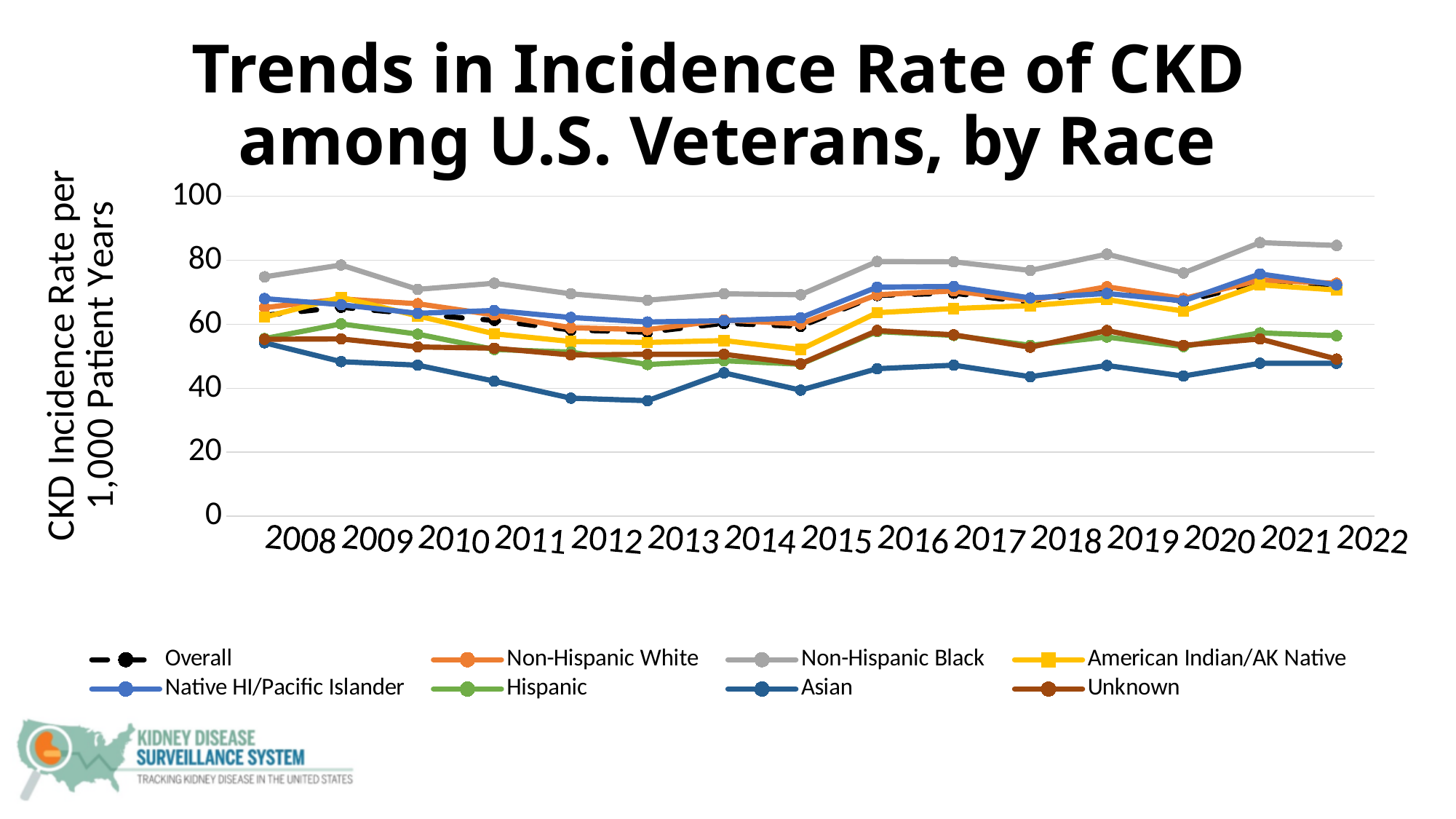
Is the value for Hispanic in 2008 greater or less than 60? less Does the Asian series rise or fall from 2008 to 2012? fall Is the value for Non-Hispanic Black in 2021 greater or less than 80? greater What is the title of the chart? Trends in Incidence Rate of CKD among U.S. Veterans, by Race Which race group has the lowest CKD incidence rate in 2012? Asian How many years are plotted along the x axis? 15 Which race group has the highest CKD incidence rate in 2022? Non-Hispanic Black In 2015, which is larger: the value for Non-Hispanic Black or the value for Asian? Non-Hispanic Black What kind of chart is shown on the slide? line chart Is the value for Asian in 2012 greater or less than 40? less Which series is drawn with a dashed black line? Overall How many series does the legend list? 8